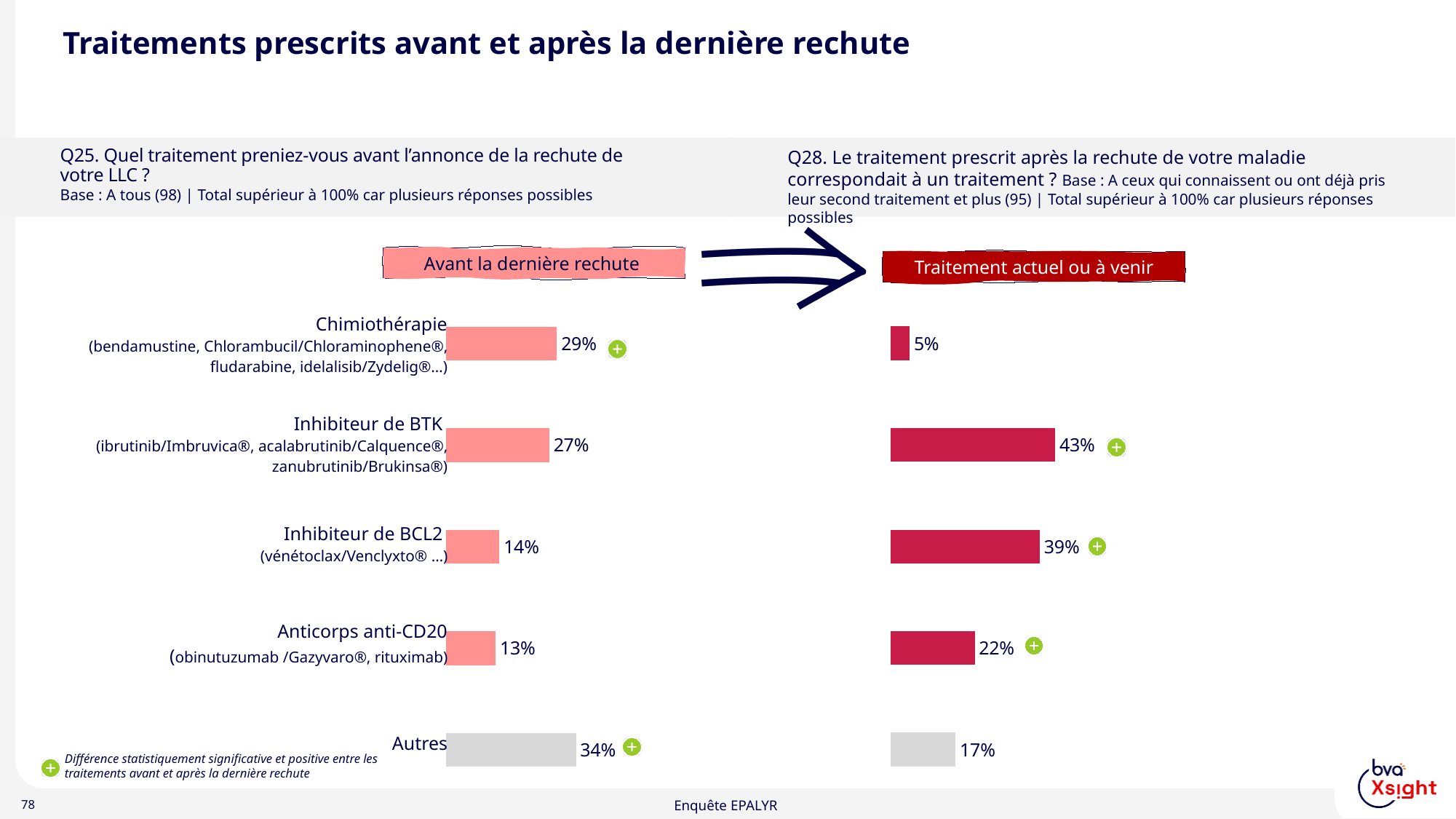
What is the difference between the Inhibiteur de BTK values in the 'Traitement actuel ou à venir' chart and the 'Avant la dernière rechute' chart? 16 percentage points In the 'Traitement actuel ou à venir' chart, which category has the lowest value? Chimiothérapie How many categories are shown in the 'Avant la dernière rechute' chart? 5 In the 'Avant la dernière rechute' chart, which category has the highest value? Autres In the 'Traitement actuel ou à venir' chart, what is the difference between Inhibiteur de BTK and Inhibiteur de BCL2? 4 percentage points In the 'Avant la dernière rechute' chart, what is the value for Chimiothérapie? 29% What kind of chart is the 'Traitement actuel ou à venir' chart? Bar chart In the 'Traitement actuel ou à venir' chart, what is the value for Inhibiteur de BTK? 43% In the 'Avant la dernière rechute' chart, what is the value for Inhibiteur de BCL2? 14% In the 'Traitement actuel ou à venir' chart, what is the value for Anticorps anti-CD20? 22% In the 'Traitement actuel ou à venir' chart, which category has the highest value? Inhibiteur de BTK Is the value for Chimiothérapie larger in the 'Avant la dernière rechute' chart or in the 'Traitement actuel ou à venir' chart? Avant la dernière rechute